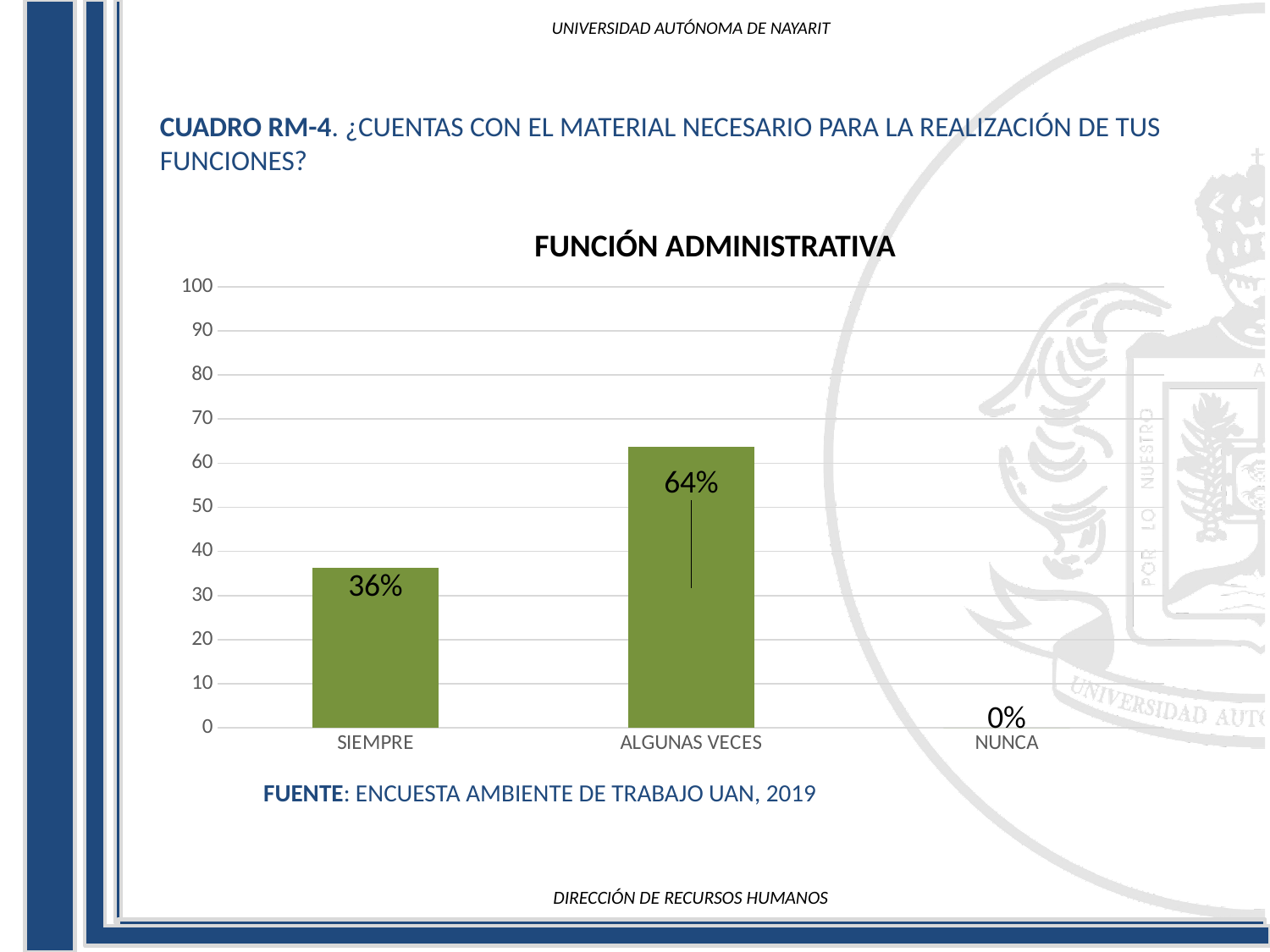
Is the value for SIEMPRE greater or less than 40? less Which category has the lowest value? NUNCA Which category has the highest value? ALGUNAS VECES How many categories are shown on the x axis? 3 Is the value for ALGUNAS VECES greater or less than 50? greater What is the value for NUNCA? 0% Which is larger, the value for SIEMPRE or the value for ALGUNAS VECES? ALGUNAS VECES What is the value for ALGUNAS VECES? 64% What is the difference between the values for ALGUNAS VECES and SIEMPRE? 28% What kind of chart is shown on the slide? bar chart What is the title of the chart? FUNCIÓN ADMINISTRATIVA What is the value for SIEMPRE? 36%